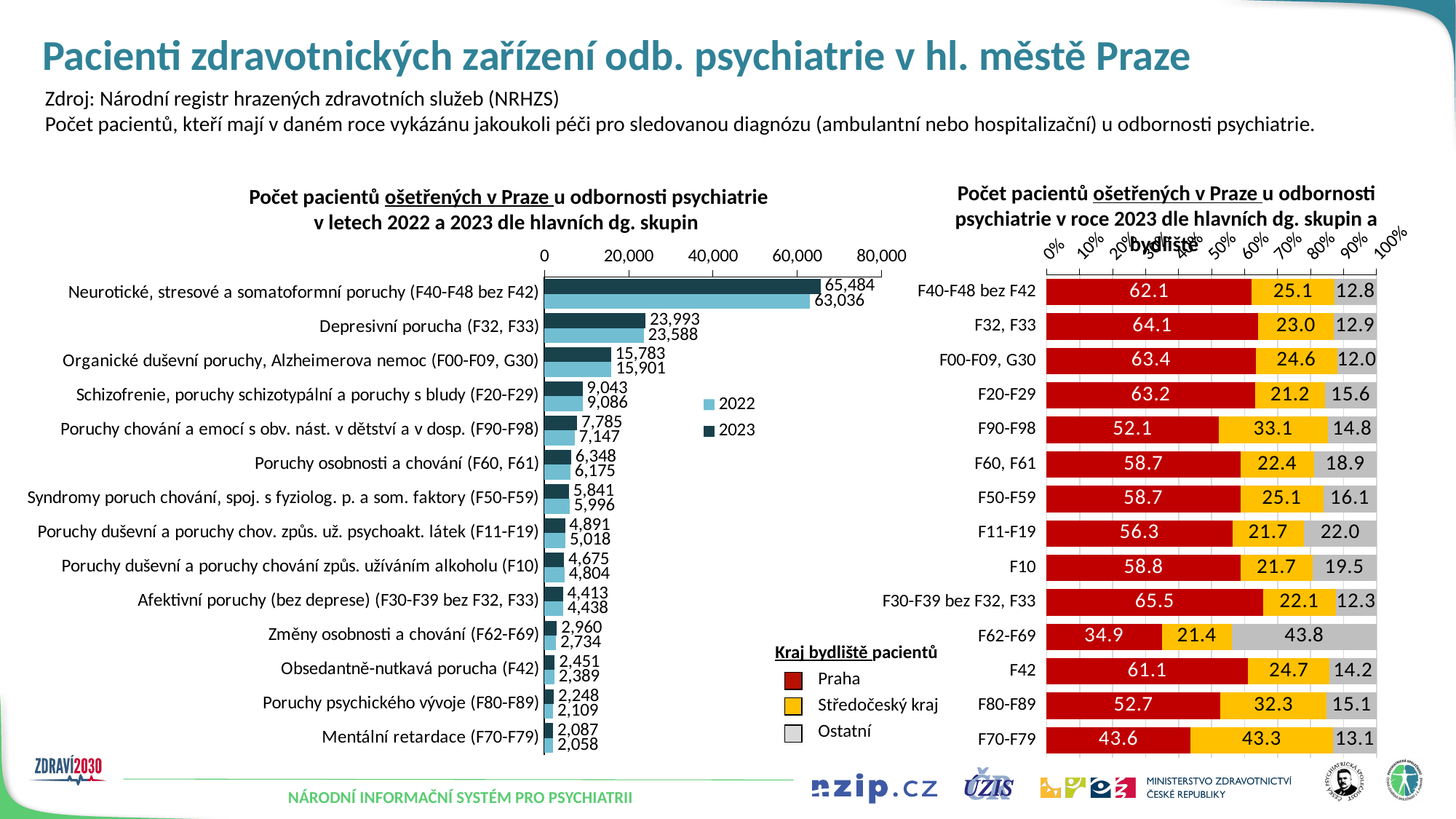
In the right chart, how many series does the legend (Kraj bydliště pacientů) list? 3 In the right chart, which diagnostic group has the highest Ostatní share? F62-F69 In the left chart, what is the difference between the 2023 and 2022 values for Neurotické, stresové a somatoformní poruchy (F40-F48 bez F42)? 2,448 In the left chart, how many series does the legend list? 2 In the left chart, which diagnostic group has the lowest 2023 value? Mentální retardace (F70-F79) In the left chart (Počet pacientů ošetřených v Praze ... v letech 2022 a 2023), what is the 2023 value for Neurotické, stresové a somatoformní poruchy (F40-F48 bez F42)? 65,484 In the right chart (Počet pacientů ošetřených v Praze ... v roce 2023 dle hlavních dg. skupin a bydliště), what is the Praha share for F90-F98? 52.1 In the right chart, what is the Středočeský kraj share for F70-F79? 43.3 What type of chart is the left chart? Bar chart In the left chart, for Organické duševní poruchy, Alzheimerova nemoc (F00-F09, G30), which year has the larger value, 2022 or 2023? 2022 In the left chart, what is the 2022 value for Depresivní porucha (F32, F33)? 23,588 In the left chart, how many diagnostic groups are shown? 14